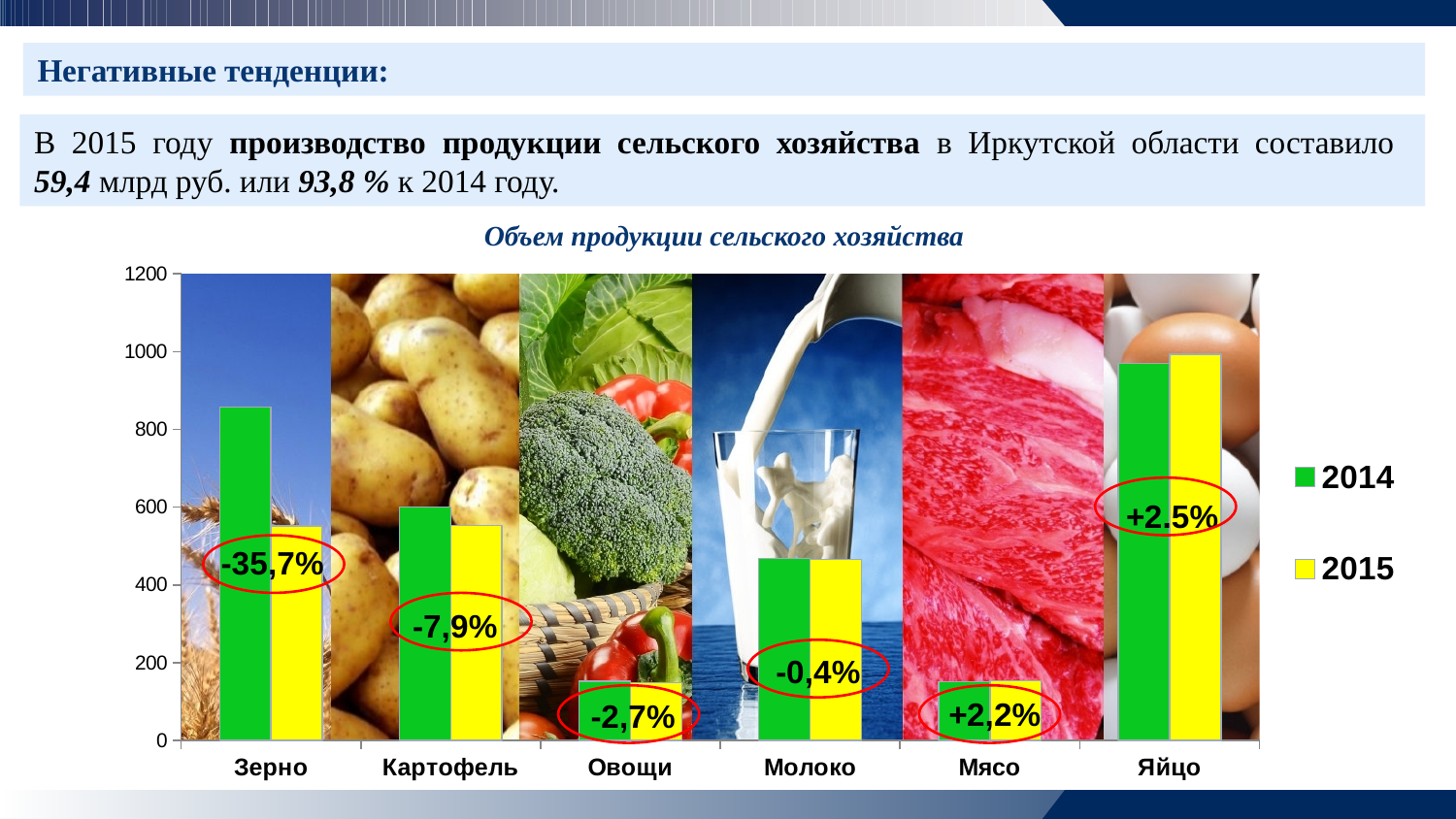
Which category has the largest labelled percentage decline? Зерно What percentage change is labelled for Молоко? -0,4% What percentage change is labelled for Картофель? -7,9% Is the 2014 value for Зерно greater or less than 800? greater Which is larger, the 2014 value for Зерно or the 2014 value for Картофель? Зерно How many series does the legend list? 2 What is the title of the chart? Объем продукции сельского хозяйства Which category has the highest bars for both 2014 and 2015? Яйцо Is the 2015 value for Овощи greater or less than 200? less What kind of chart is shown on the slide? bar chart What percentage change is labelled for Зерно? -35,7% How many categories are shown on the x axis of the chart? 6